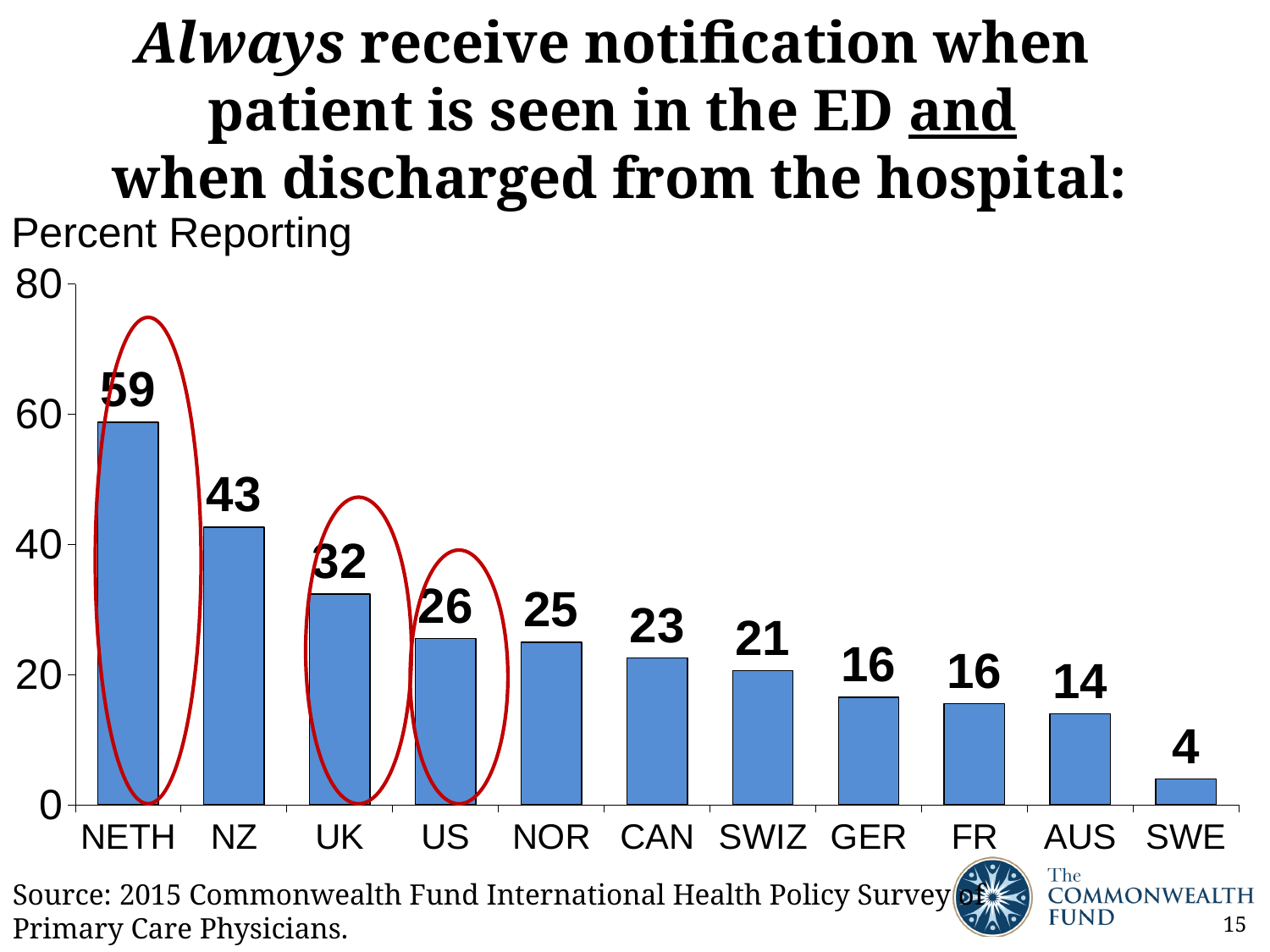
Which country has the highest value? NETH What is the difference between the values for UK and SWE? 28 Which is larger, the value for NZ or the value for NOR? NZ Which three countries are circled in red on the chart? NETH, UK, US What is the value for SWIZ? 21 Do the values rise or fall from left to right along the x axis? fall What is the difference between the values for NETH and NZ? 16 What kind of chart is this? bar chart What is the value for US? 26 Which country has the lowest value? SWE What is the value for NETH? 59 How many countries are shown on the chart? 11